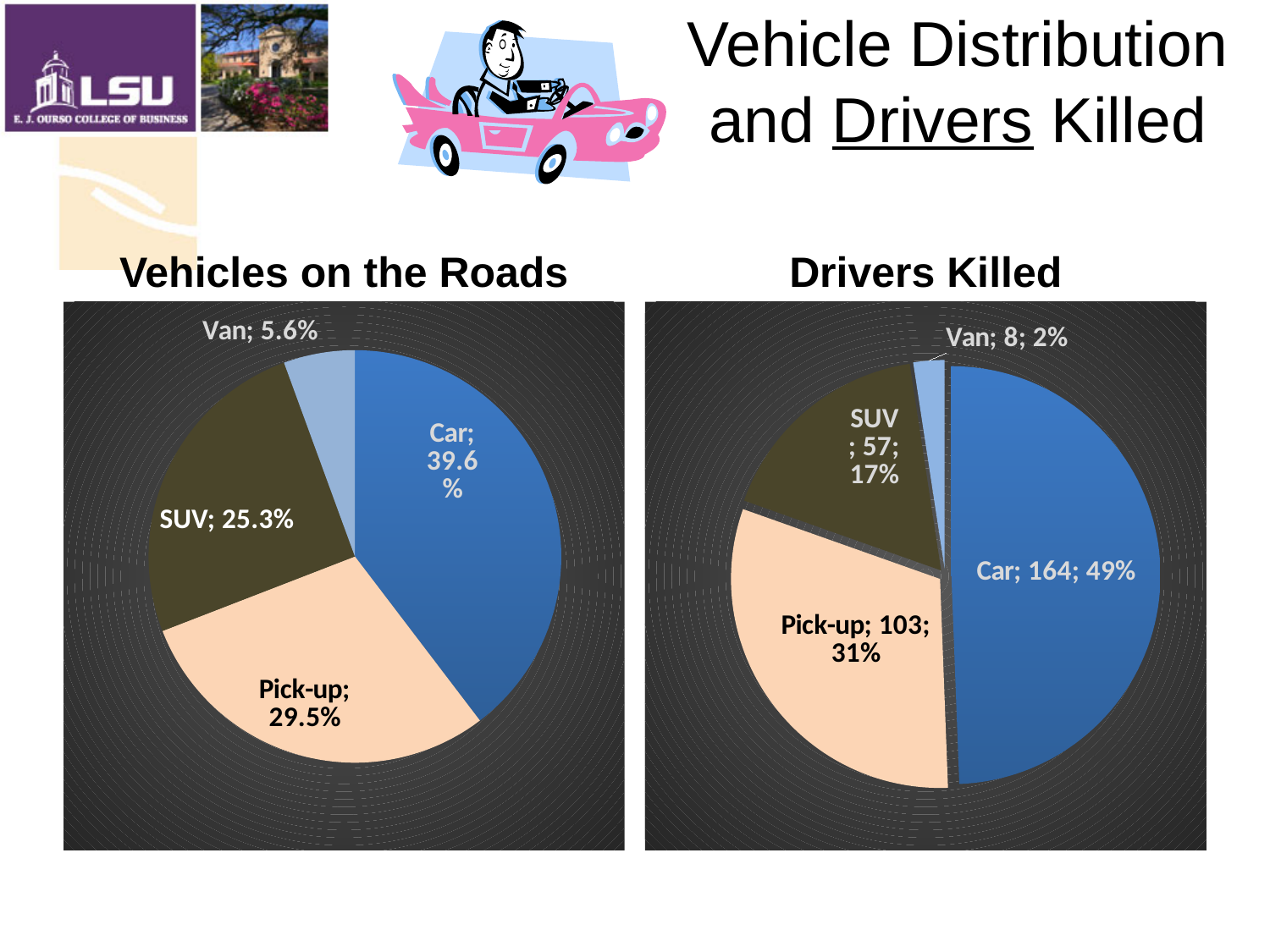
How many categories does the 'Drivers Killed' chart show? 4 In the 'Drivers Killed' chart, what percentage of drivers killed were in cars? 49% In the 'Drivers Killed' chart, which vehicle type has the fewest drivers killed? Van In the 'Drivers Killed' chart, how many drivers killed were in pick-ups? 103 What type of chart is the 'Vehicles on the Roads' chart? Pie chart In the 'Drivers Killed' chart, how many drivers killed were in SUVs? 57 In the 'Vehicles on the Roads' chart, what share of vehicles are cars? 39.6% In the 'Vehicles on the Roads' chart, which vehicle type has the smallest share? Van In the 'Drivers Killed' chart, how many more drivers were killed in cars than in pick-ups? 61 In the 'Vehicles on the Roads' chart, which vehicle type has the largest share? Car In the 'Vehicles on the Roads' chart, what share of vehicles are vans? 5.6% In the 'Vehicles on the Roads' chart, what is the difference in percentage points between the Pick-up share and the SUV share? 4.2